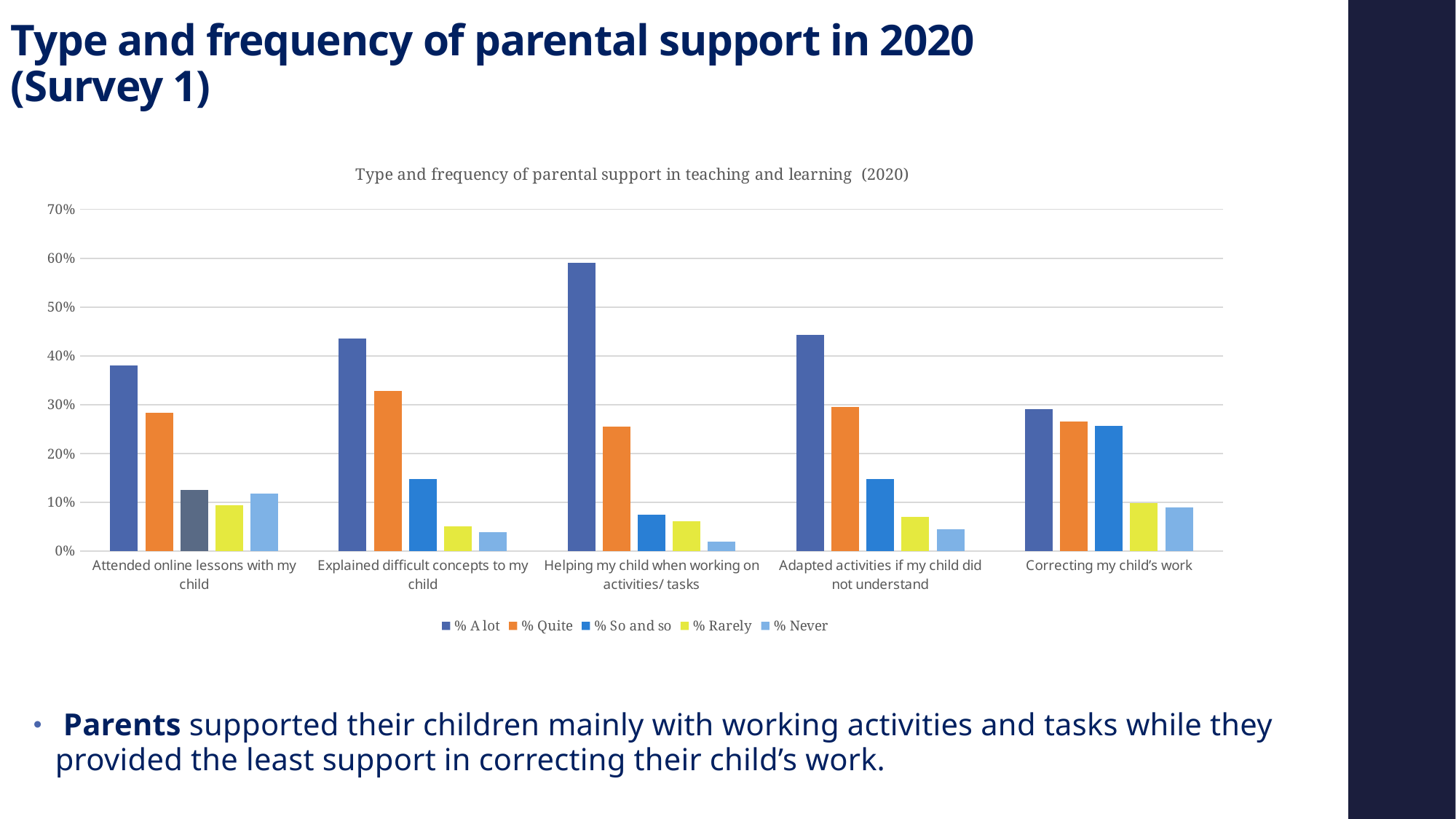
Which category has the lowest value for the "% Never" series? Helping my child when working on activities/ tasks Is the "% A lot" value for "Attended online lessons with my child" greater or less than 30%? greater Is the "% A lot" value for "Helping my child when working on activities/ tasks" greater or less than 50%? greater How many series does the chart legend list? 5 Which category has the larger "% Never" value: "Attended online lessons with my child" or "Explained difficult concepts to my child"? Attended online lessons with my child What is the title of the chart? Type and frequency of parental support in teaching and learning (2020) Which category has the lowest value for the "% A lot" series? Correcting my child's work Is the "% Never" value for "Helping my child when working on activities/ tasks" greater or less than 10%? less Which category has the highest value for the "% A lot" series? Helping my child when working on activities/ tasks For "Attended online lessons with my child", which is larger: "% A lot" or "% Quite"? % A lot How many categories of parental support are shown on the x axis? 5 What kind of chart is shown on the slide? Bar chart